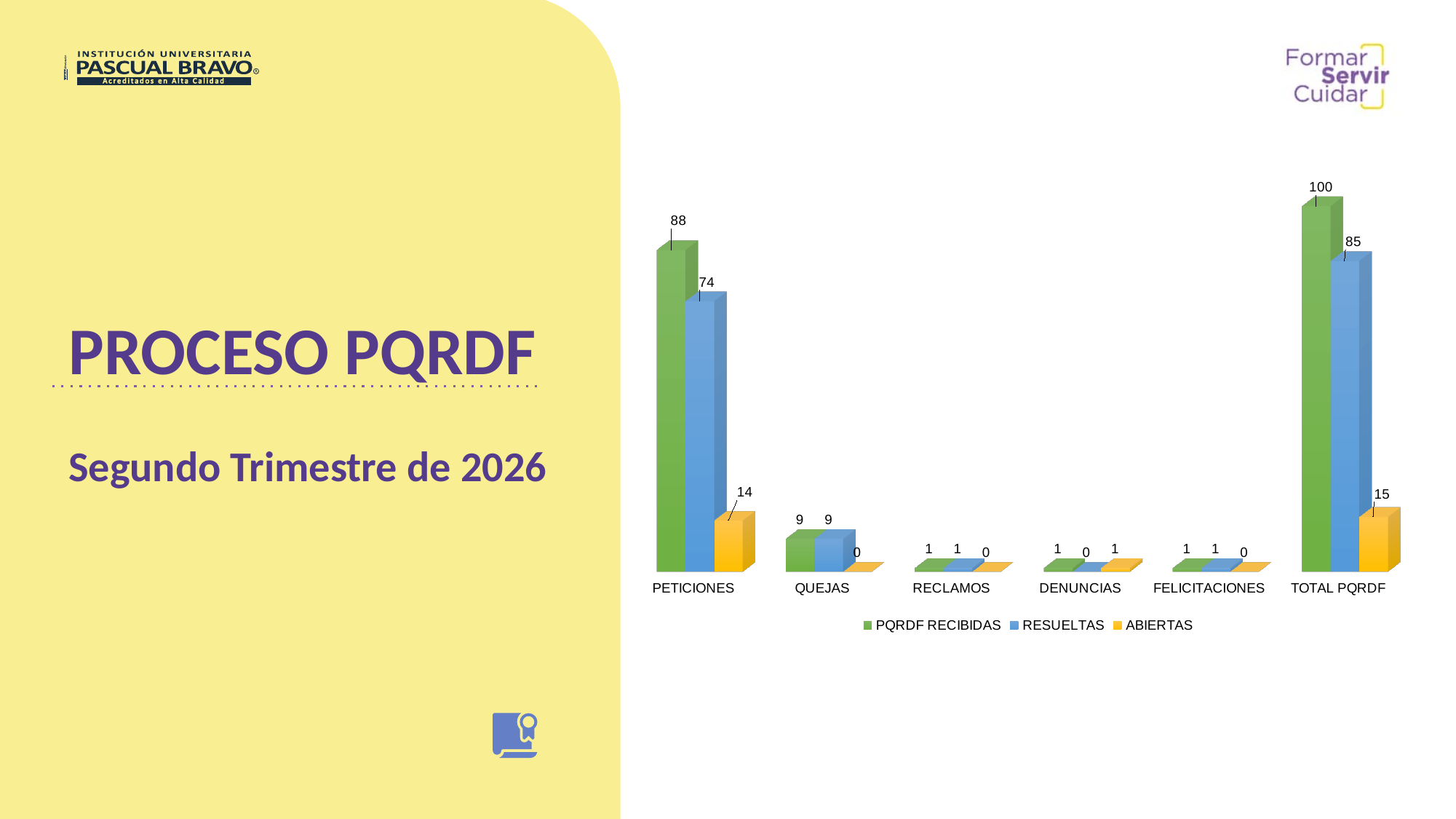
How many categories are shown on the x axis? 6 What is the value of ABIERTAS for TOTAL PQRDF? 15 How many series does the legend list? 3 Which is larger for QUEJAS: PQRDF RECIBIDAS or ABIERTAS? PQRDF RECIBIDAS Which colour represents the ABIERTAS series? Yellow What is the difference between PQRDF RECIBIDAS and RESUELTAS for PETICIONES? 14 What is the difference between PQRDF RECIBIDAS and RESUELTAS for TOTAL PQRDF? 15 What kind of chart is shown on the slide? Bar chart What is the value of RESUELTAS for PETICIONES? 74 Which category has the highest value for PQRDF RECIBIDAS? TOTAL PQRDF What is the value of PQRDF RECIBIDAS for PETICIONES? 88 What is the value of RESUELTAS for DENUNCIAS? 0